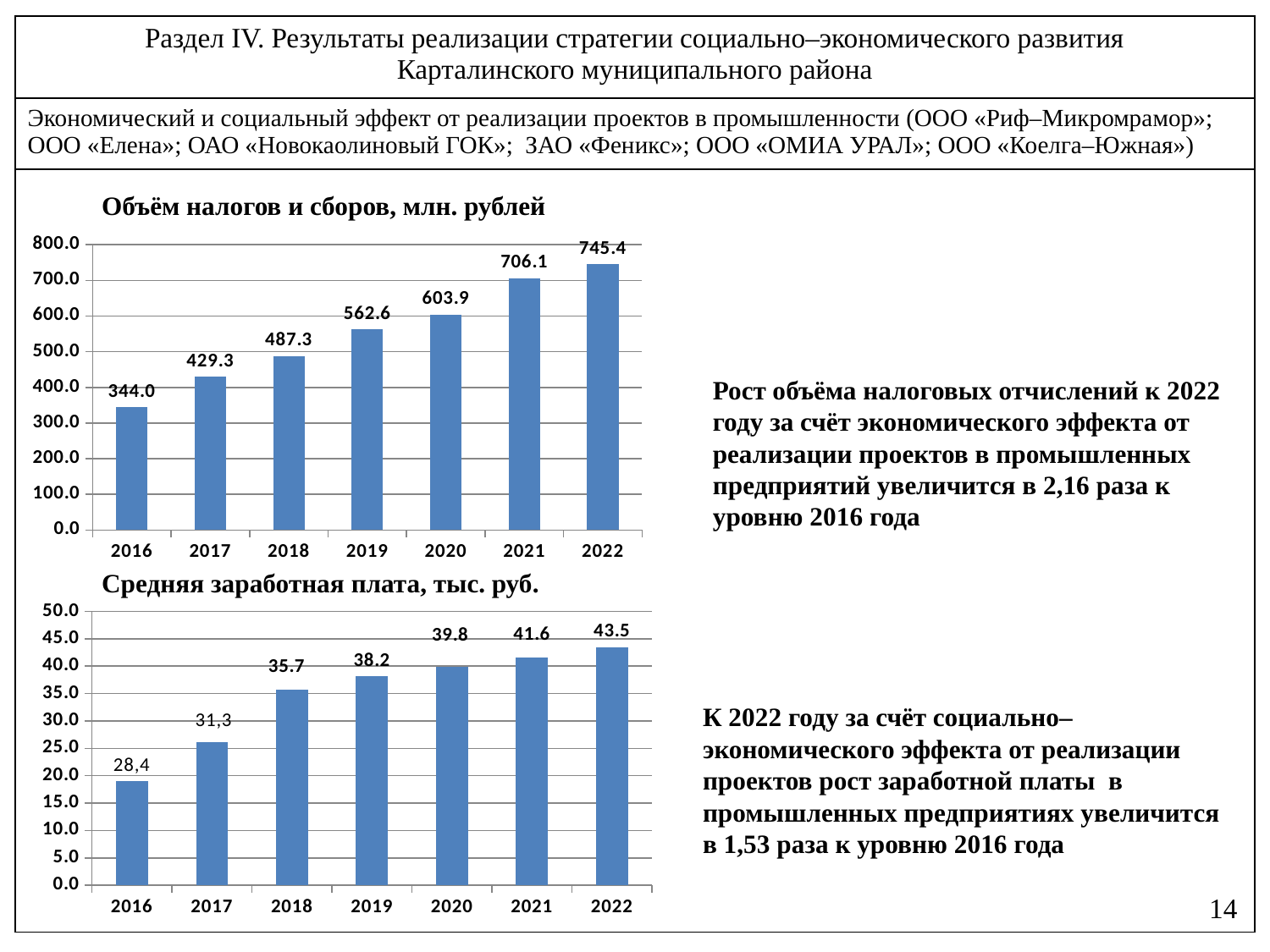
In the chart 'Средняя заработная плата, тыс. руб.', which year has the lowest value? 2016 In the chart 'Средняя заработная плата, тыс. руб.', what is the difference between the values for 2019 and 2018? 2.5 In the chart 'Объём налогов и сборов, млн. рублей', what is the value for 2016? 344.0 In the chart 'Объём налогов и сборов, млн. рублей', what is the value for 2019? 562.6 In the chart 'Объём налогов и сборов, млн. рублей', which year has the highest value? 2022 In the chart 'Объём налогов и сборов, млн. рублей', what is the difference between the values for 2022 and 2021? 39.3 In the chart 'Средняя заработная плата, тыс. руб.', what is the value for 2020? 39.8 What kind of chart is 'Объём налогов и сборов, млн. рублей'? bar chart In the chart 'Объём налогов и сборов, млн. рублей', do the values rise or fall from 2016 to 2022? rise In the chart 'Средняя заработная плата, тыс. руб.', what is the value for 2022? 43.5 In the chart 'Средняя заработная плата, тыс. руб.', which is larger, the value for 2018 or the value for 2021? 2021 In the chart 'Объём налогов и сборов, млн. рублей', how many years are shown on the x axis? 7